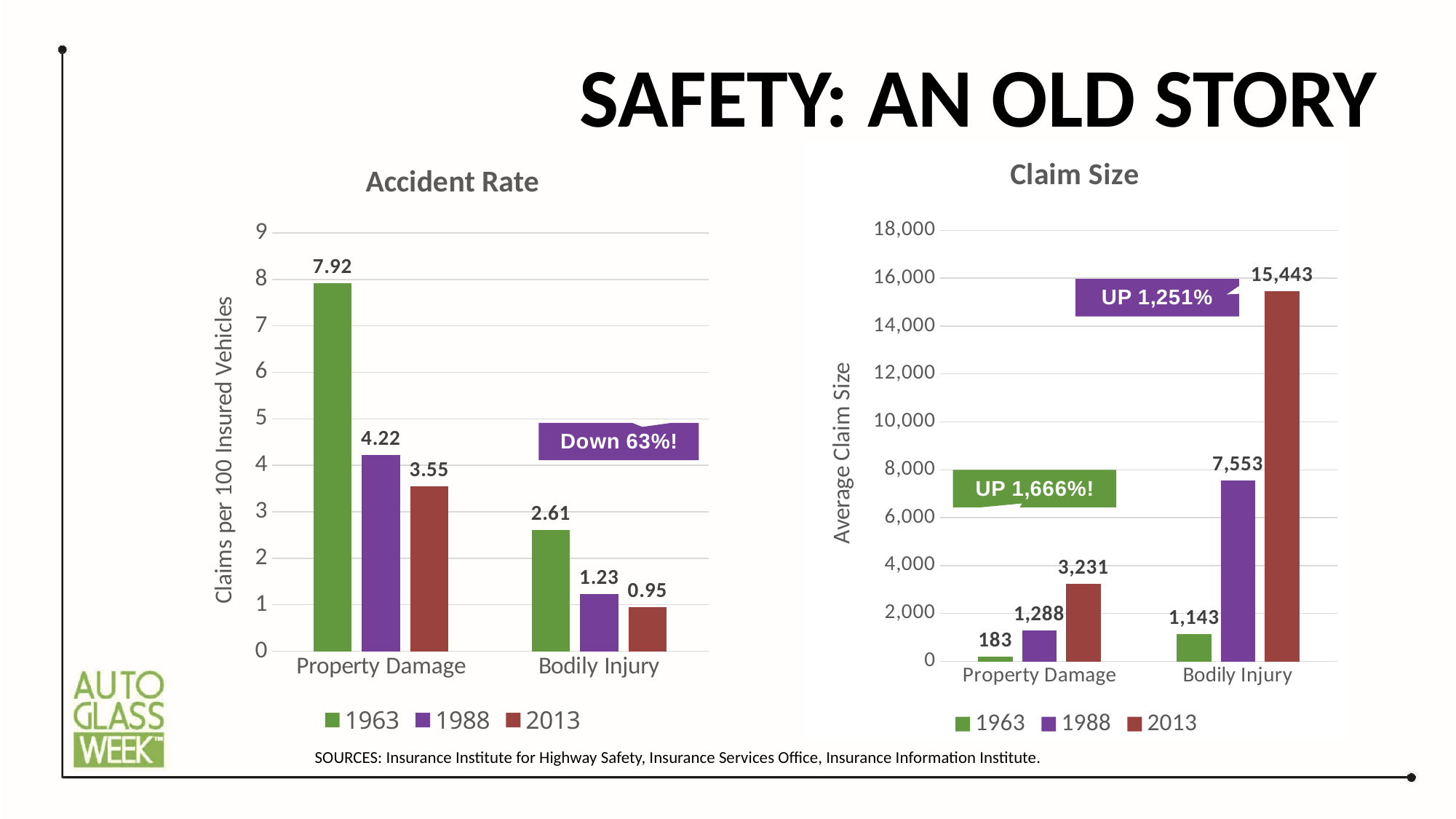
In the Accident Rate chart, what is the value for 1963 in the Property Damage category? 7.92 In the Accident Rate chart, what is the value for 2013 in the Bodily Injury category? 0.95 In the Accident Rate chart, what is the difference between the 1963 and 2013 values for Property Damage? 4.37 In the Claim Size chart, which is larger: the 2013 value for Property Damage or the 1963 value for Bodily Injury? 2013 Property Damage In the Claim Size chart, what is the value for 1963 in the Property Damage category? 183 What is the y-axis label of the Accident Rate chart? Claims per 100 Insured Vehicles How many series does the legend of the Accident Rate chart list? 3 In the Claim Size chart, what is the difference between the 2013 and 1988 values for Bodily Injury? 7,890 What kind of chart is the Claim Size chart? Bar chart In the Claim Size chart, which bar has the highest value? 2013 Bodily Injury In the Accident Rate chart, which bar has the lowest value? 2013 Bodily Injury In the Claim Size chart, what is the value for 1988 in the Bodily Injury category? 7,553